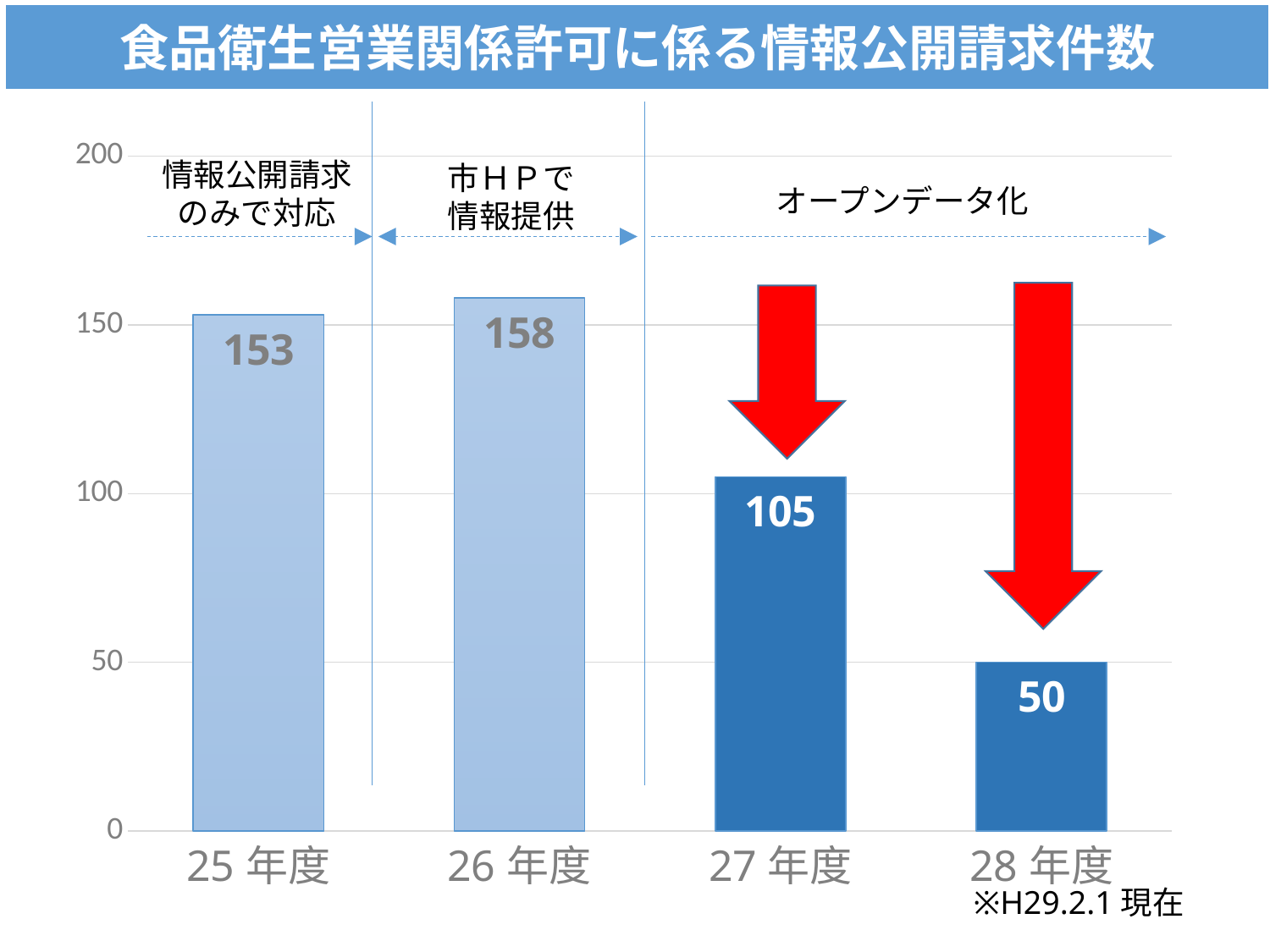
What is the value for 26年度? 158 Which year has the highest value? 26年度 How many years are shown on the x axis? 4 What is the title of the chart? 食品衛生営業関係許可に係る情報公開請求件数 Which year has the lowest value? 28年度 Which is larger, the value for 25年度 or the value for 27年度? 25年度 What is the value for 25年度? 153 What kind of chart is this? bar chart What is the difference between the values for 27年度 and 28年度? 55 What is the difference between the values for 26年度 and 27年度? 53 What is the value for 27年度? 105 What is the value for 28年度? 50